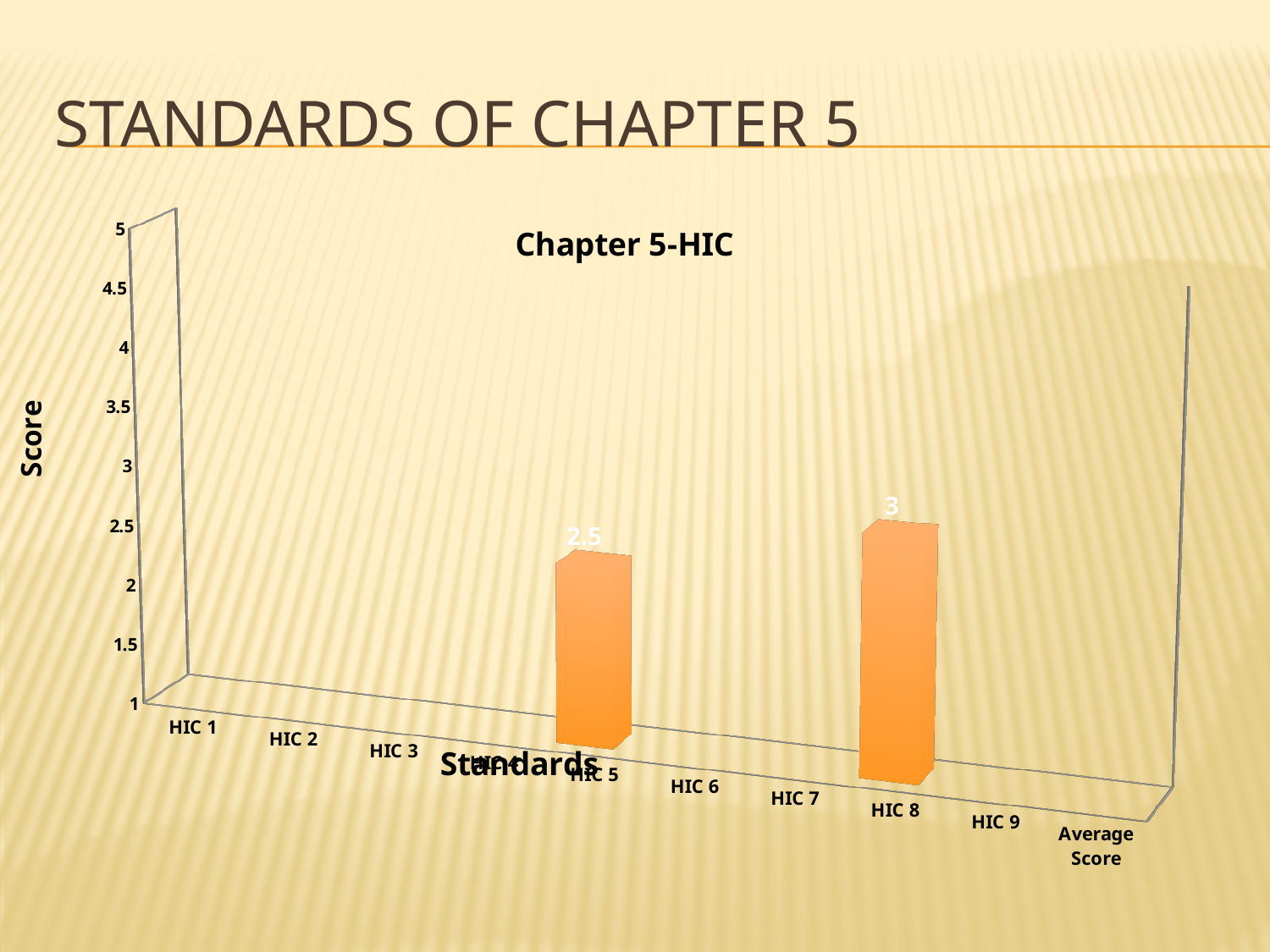
What is the label of the vertical axis of the chart? Score What is the value for HIC 8 in the Chapter 5-HIC chart? 3 How many categories are labelled on the x axis of the Chapter 5-HIC chart? 10 What is the difference between the values for HIC 8 and HIC 5? 0.5 What is the title of the chart on the slide? Chapter 5-HIC Which is larger, the value for HIC 5 or the value for HIC 8? HIC 8 Is the value for HIC 5 greater or less than 3? less Which category has the highest bar in the Chapter 5-HIC chart? HIC 8 What kind of chart is shown on the slide? Bar chart What is the value for HIC 5 in the Chapter 5-HIC chart? 2.5 Is the value for HIC 8 greater or less than 2? greater